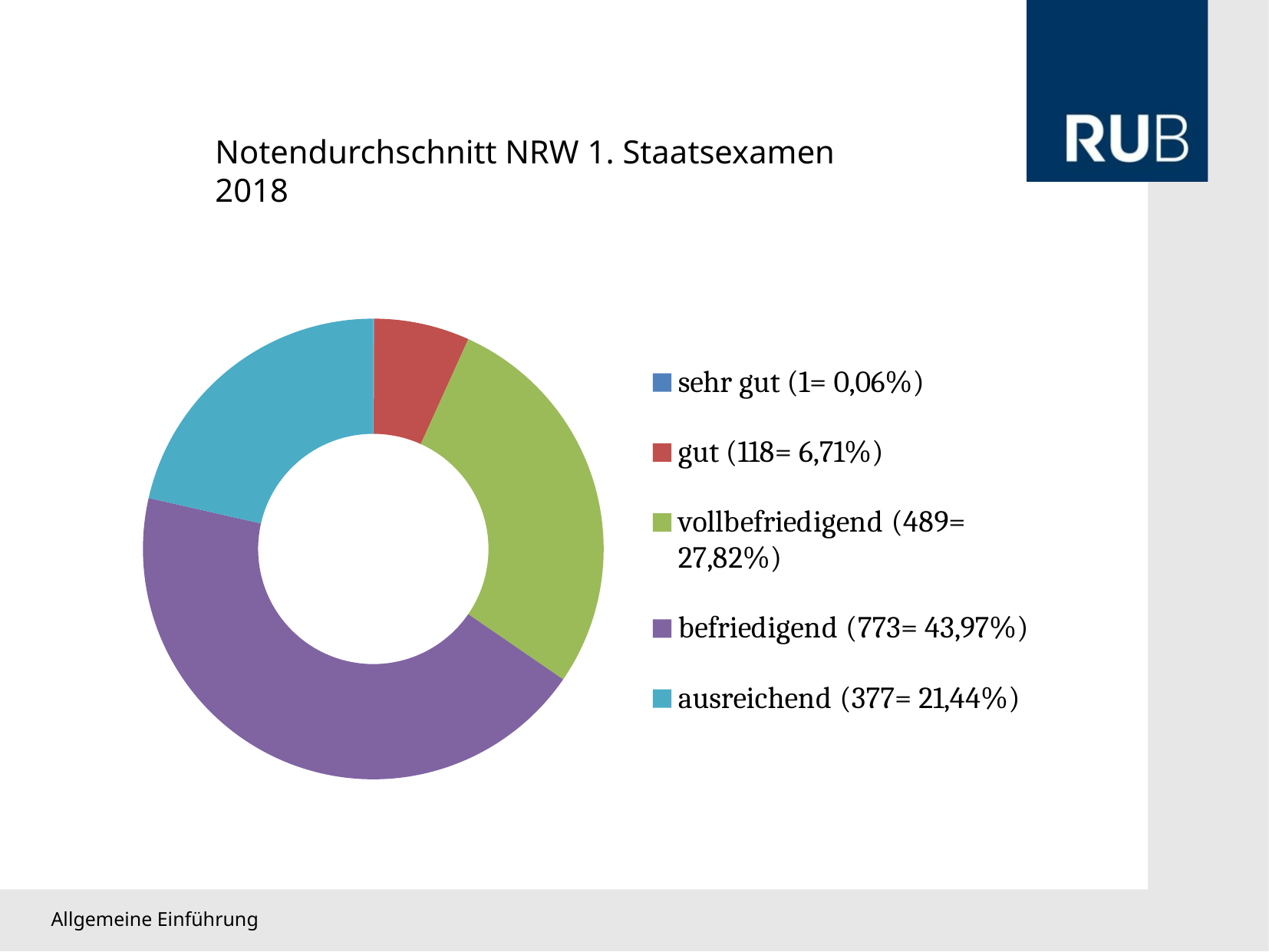
Which grade category has the smallest share? sehr gut What percentage share does "vollbefriedigend" have? 27,82% What is the total number of candidates across all grade categories? 1758 How many candidates received the grade "gut"? 118 Which has more candidates, "vollbefriedigend" or "ausreichend"? vollbefriedigend What kind of chart is shown on the slide? Doughnut (pie) chart Which grade category has the largest share? befriedigend What percentage share does "ausreichend" have? 21,44% How many grade categories does the chart show? 5 What is the difference in the number of candidates between "befriedigend" and "ausreichend"? 396 How many candidates received the grade "befriedigend"? 773 What is the title of the chart? Notendurchschnitt NRW 1. Staatsexamen 2018